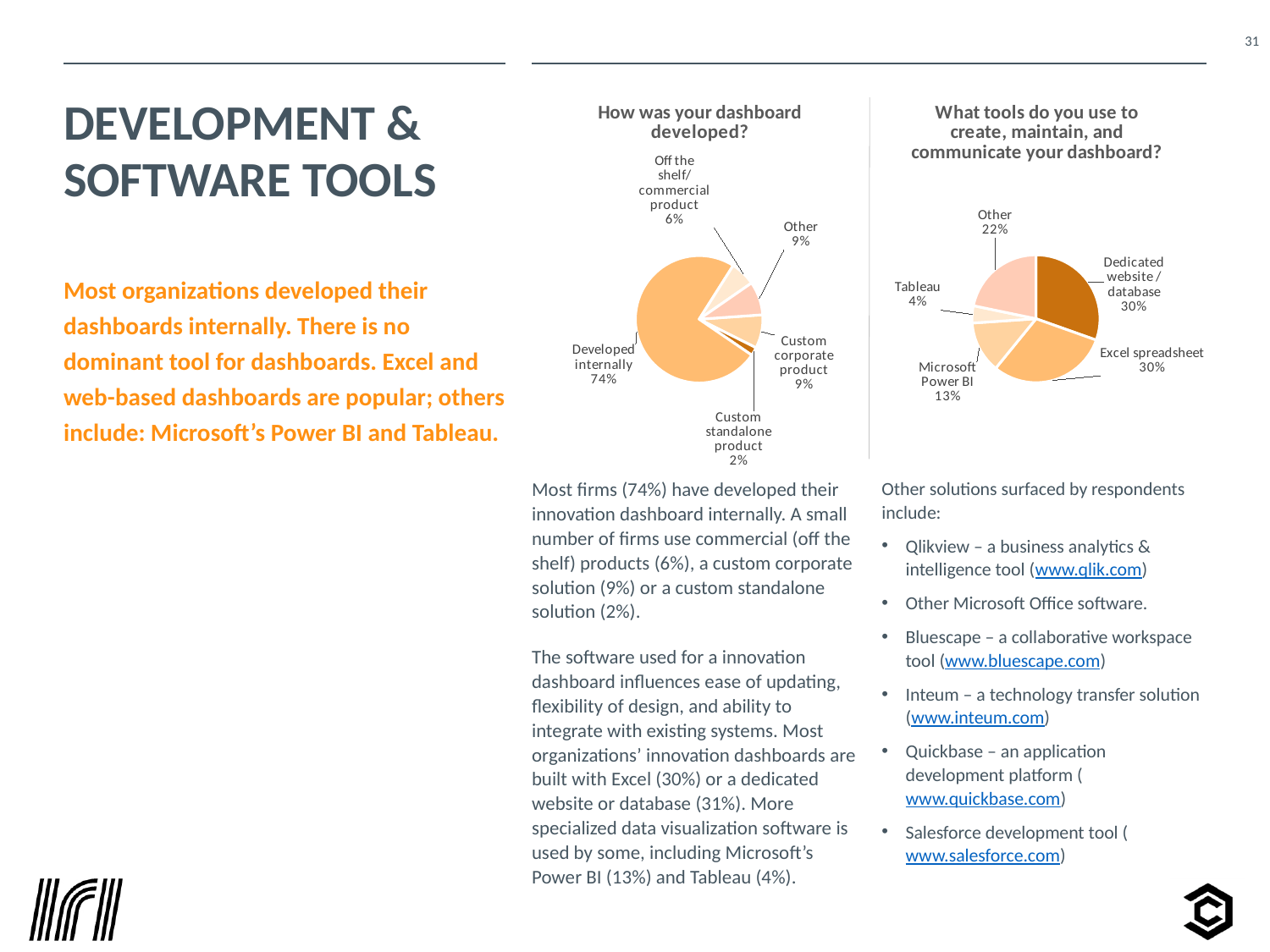
In the chart titled "What tools do you use to create, maintain, and communicate your dashboard?", what is the difference between Other and Tableau? 18% In the chart titled "How was your dashboard developed?", which category has the smallest share? Custom standalone product In the chart titled "How was your dashboard developed?", what is the difference between Developed internally and Off the shelf/commercial product? 68% In the chart titled "How was your dashboard developed?", what share of respondents developed their dashboard internally? 74% In the chart titled "What tools do you use to create, maintain, and communicate your dashboard?", which is larger: Other or Microsoft Power BI? Other In the chart titled "How was your dashboard developed?", how many categories are shown? 5 What kind of chart is the one titled "What tools do you use to create, maintain, and communicate your dashboard?"? Pie chart In the chart titled "How was your dashboard developed?", which category has the largest share? Developed internally In the chart titled "What tools do you use to create, maintain, and communicate your dashboard?", which category has the smallest share? Tableau In the chart titled "What tools do you use to create, maintain, and communicate your dashboard?", what is the value for Microsoft Power BI? 13% In the chart titled "How was your dashboard developed?", what is the value for Custom standalone product? 2% In the chart titled "What tools do you use to create, maintain, and communicate your dashboard?", what is the value for Excel spreadsheet? 30%